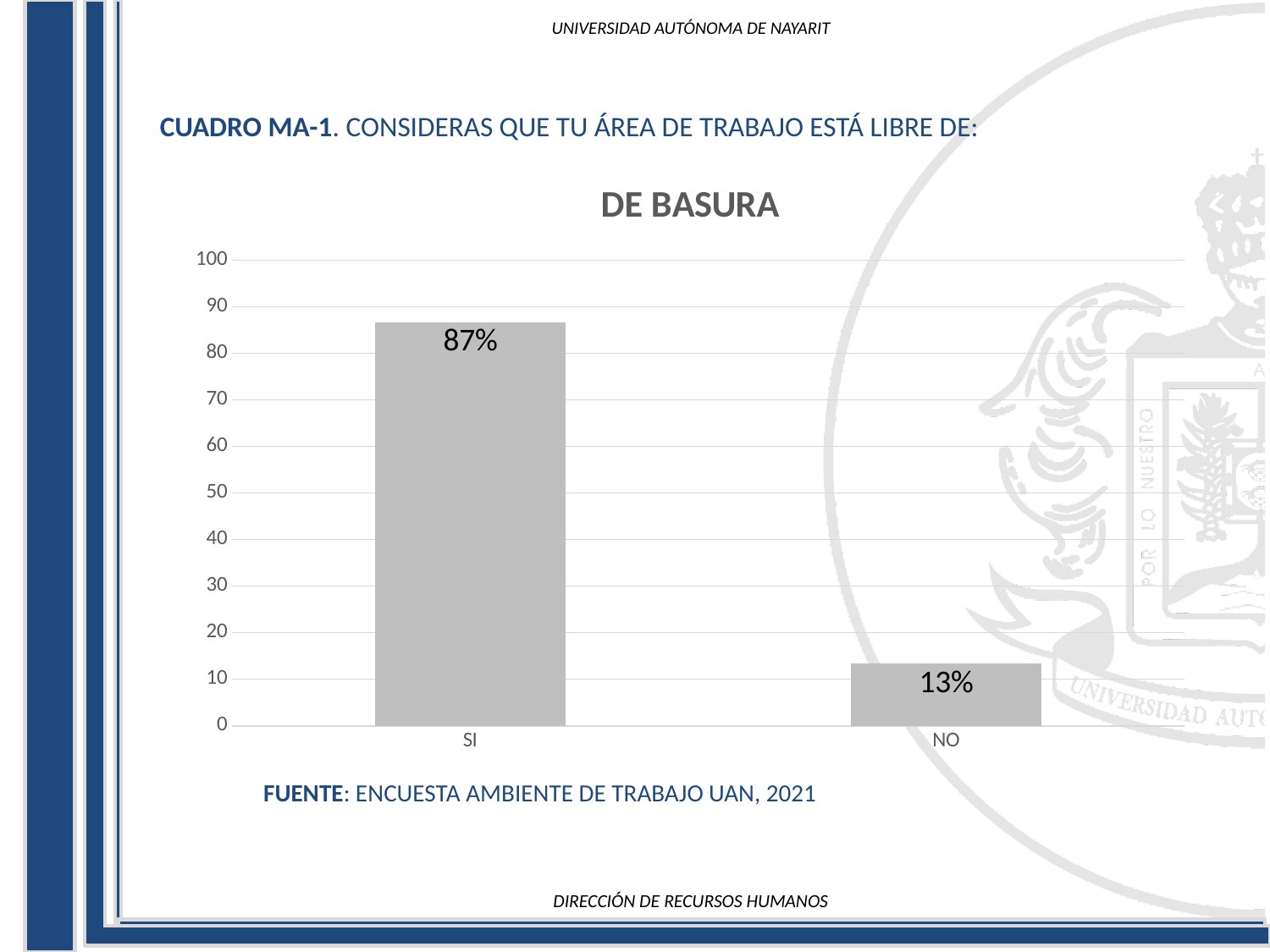
What is the value for SI in the DE BASURA chart? 87% Which category has the highest value in the DE BASURA chart? SI How many categories are shown in the DE BASURA chart? 2 What kind of chart is the DE BASURA chart? bar chart Is the value for NO greater or less than 20 in the DE BASURA chart? less Is the value for SI greater or less than 80 in the DE BASURA chart? greater Which category has the lowest value in the DE BASURA chart? NO Which is larger in the DE BASURA chart, the value for SI or the value for NO? SI What is the maximum value shown on the vertical axis of the DE BASURA chart? 100 What is the title of the chart on the slide? DE BASURA What is the difference between the values for SI and NO in the DE BASURA chart? 74% What is the value for NO in the DE BASURA chart? 13%